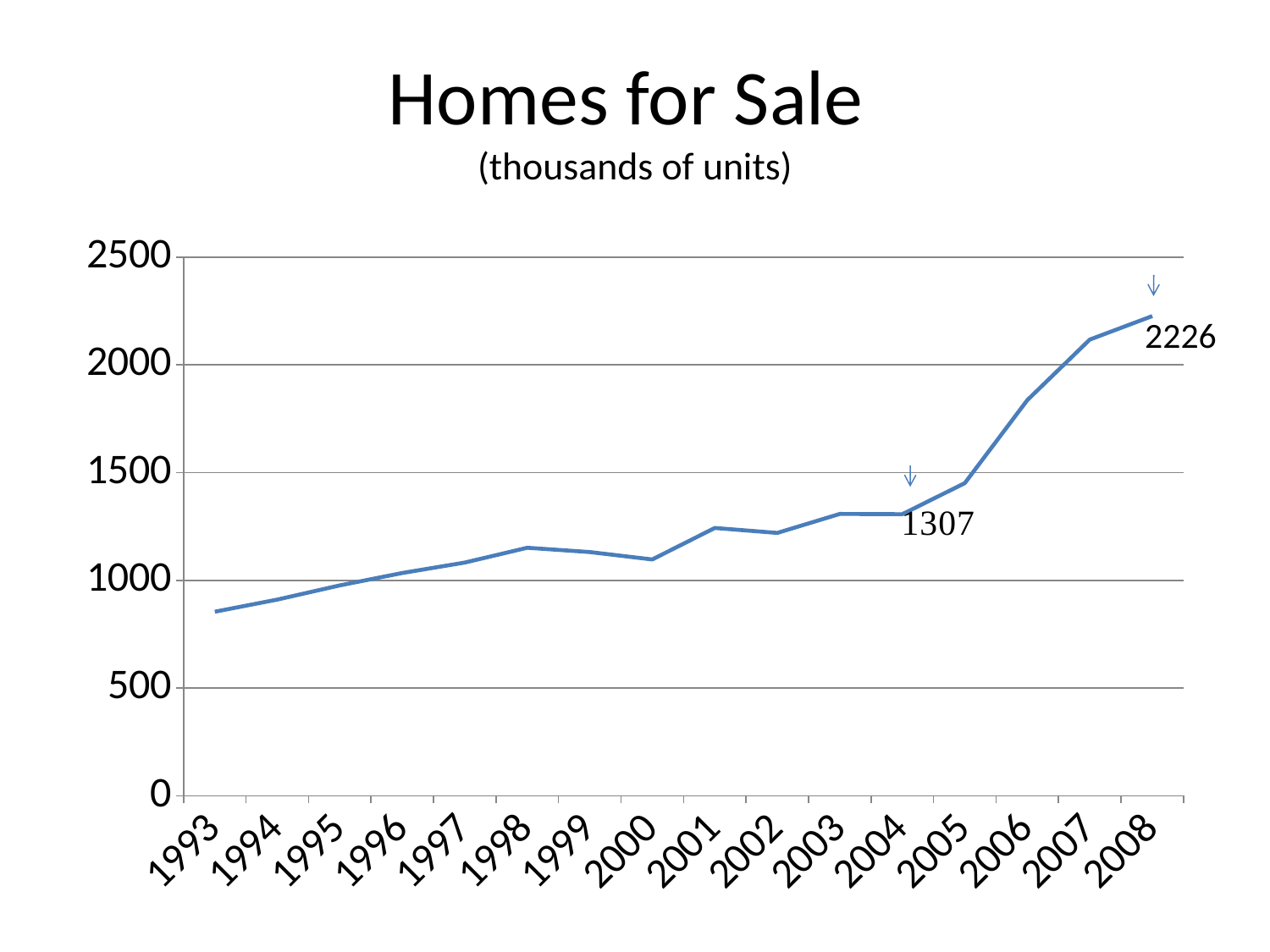
How many years are plotted on the x axis? 16 Do the values generally rise or fall from 1993 to 2008? Rise Is the value for 1993 greater or less than 1000? less Which year has the highest value? 2008 Which year has the lowest value? 1993 What unit does the chart subtitle say the values are in? thousands of units Is the value for 2007 greater or less than 2000? greater Which is larger, the value for 2001 or the value for 2000? 2001 What is the difference between the values for 2008 and 2004? 919 What kind of chart is shown? Line chart What is the value for 2004? 1307 What is the value for 2008? 2226